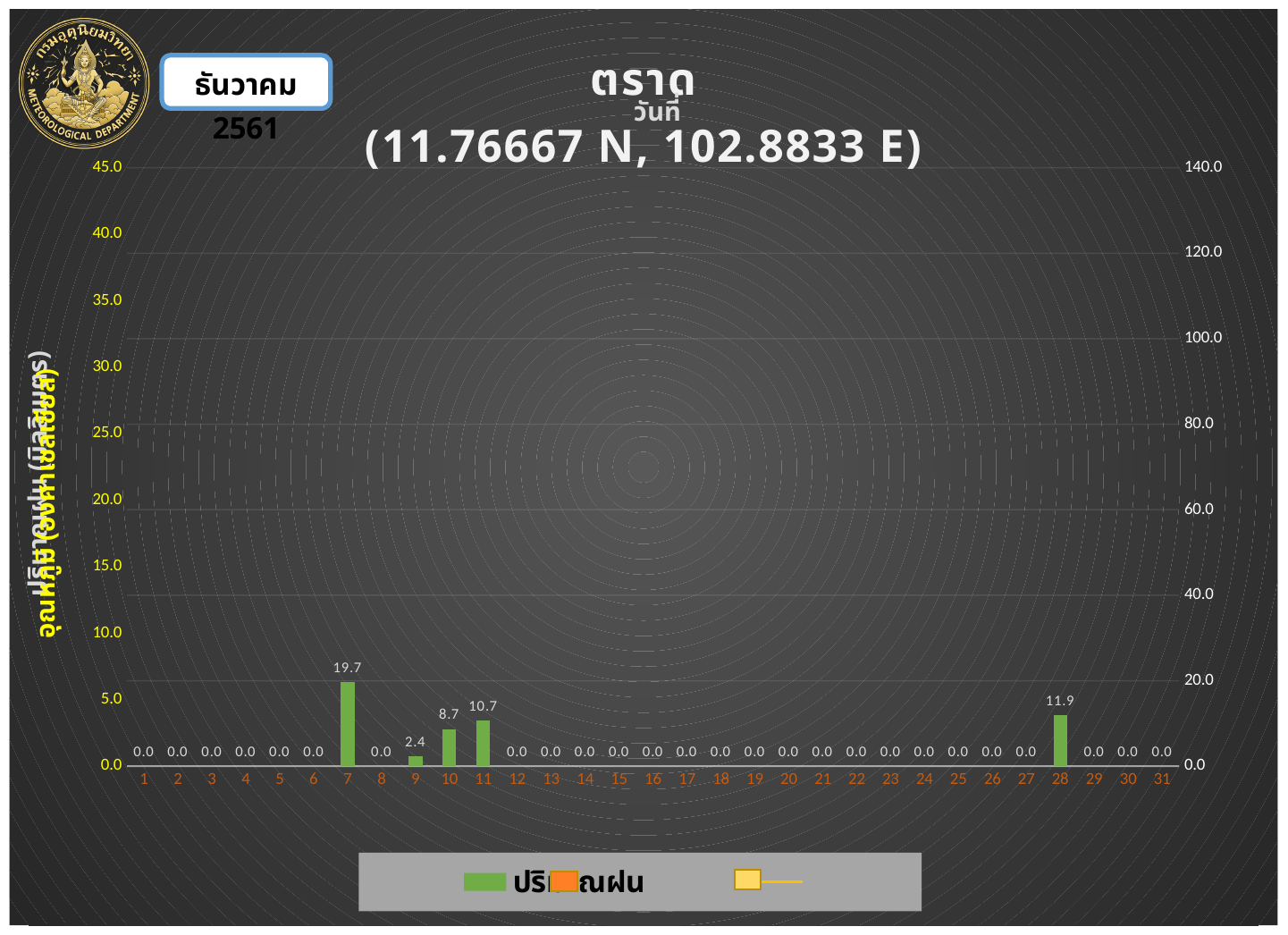
What is the rainfall value shown for day 28? 11.9 What is the rainfall value shown for day 9? 2.4 Which has the larger rainfall value, day 10 or day 11? day 11 What kind of chart is shown on the slide? bar chart What is the difference between the rainfall values for day 11 and day 10? 2.0 What is the rainfall value shown for day 11? 10.7 What is the rainfall value shown for day 7? 19.7 Is the value for day 7 greater or less than 10.0 on the right axis? greater How many days have a non-zero rainfall value? 5 What is the difference between the rainfall values for day 7 and day 28? 7.8 How many days are shown on the x axis? 31 Which day has the highest rainfall value? 7